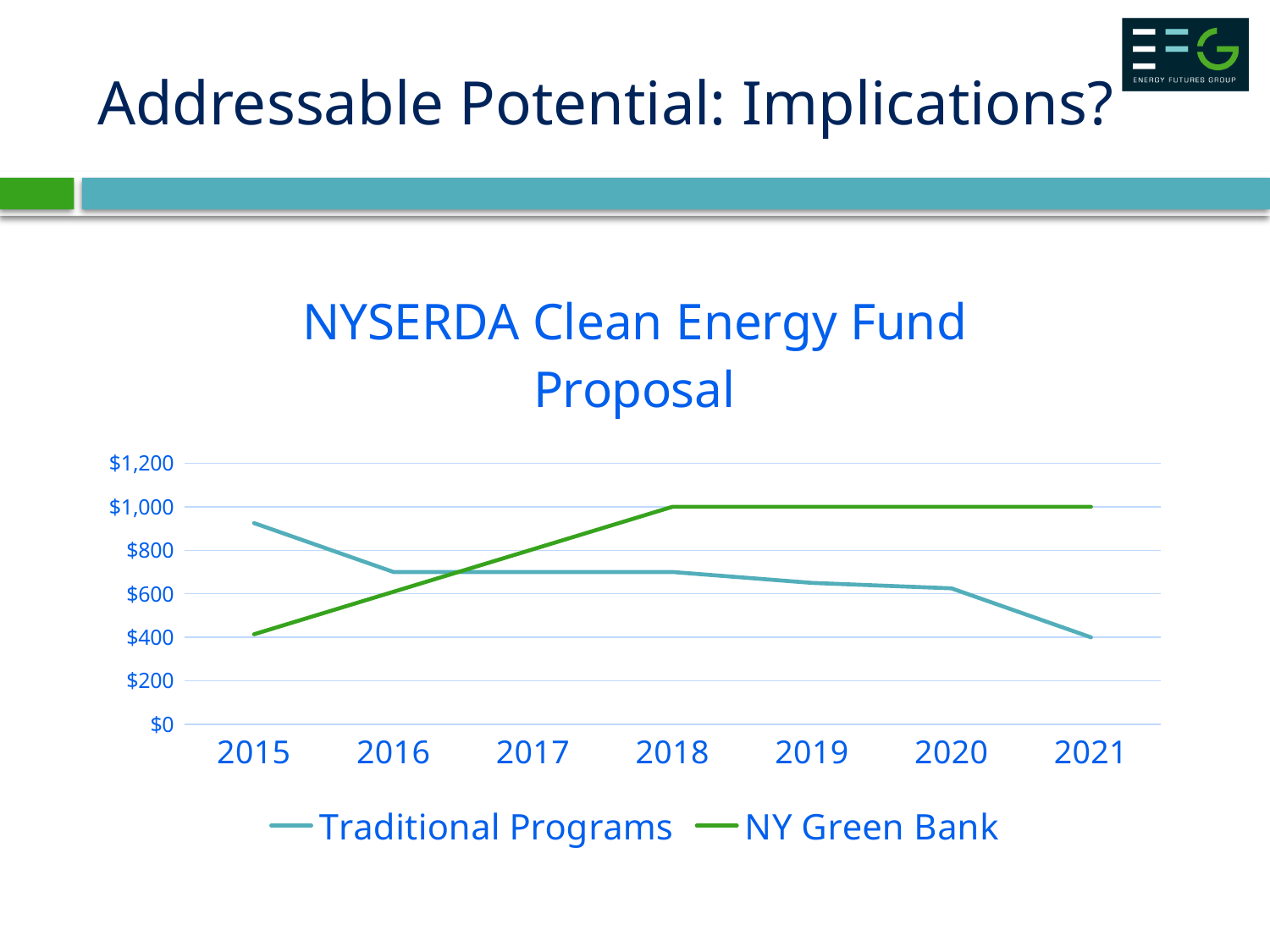
How many series does the legend list? 2 In 2021, which series has the larger value, Traditional Programs or NY Green Bank? NY Green Bank Is the value for Traditional Programs in 2015 greater or less than $800? greater What is the value for Traditional Programs in 2021? $400 In 2015, which series has the larger value, Traditional Programs or NY Green Bank? Traditional Programs Is the value for Traditional Programs in 2019 greater or less than $800? less What is the value for NY Green Bank in 2018? $1,000 In which year is the Traditional Programs value lowest? 2021 Does the Traditional Programs line generally rise or fall from 2015 to 2021? Fall How many years are shown on the x axis? 7 What is the title of the chart? NYSERDA Clean Energy Fund Proposal What kind of chart is shown on the slide? Line chart